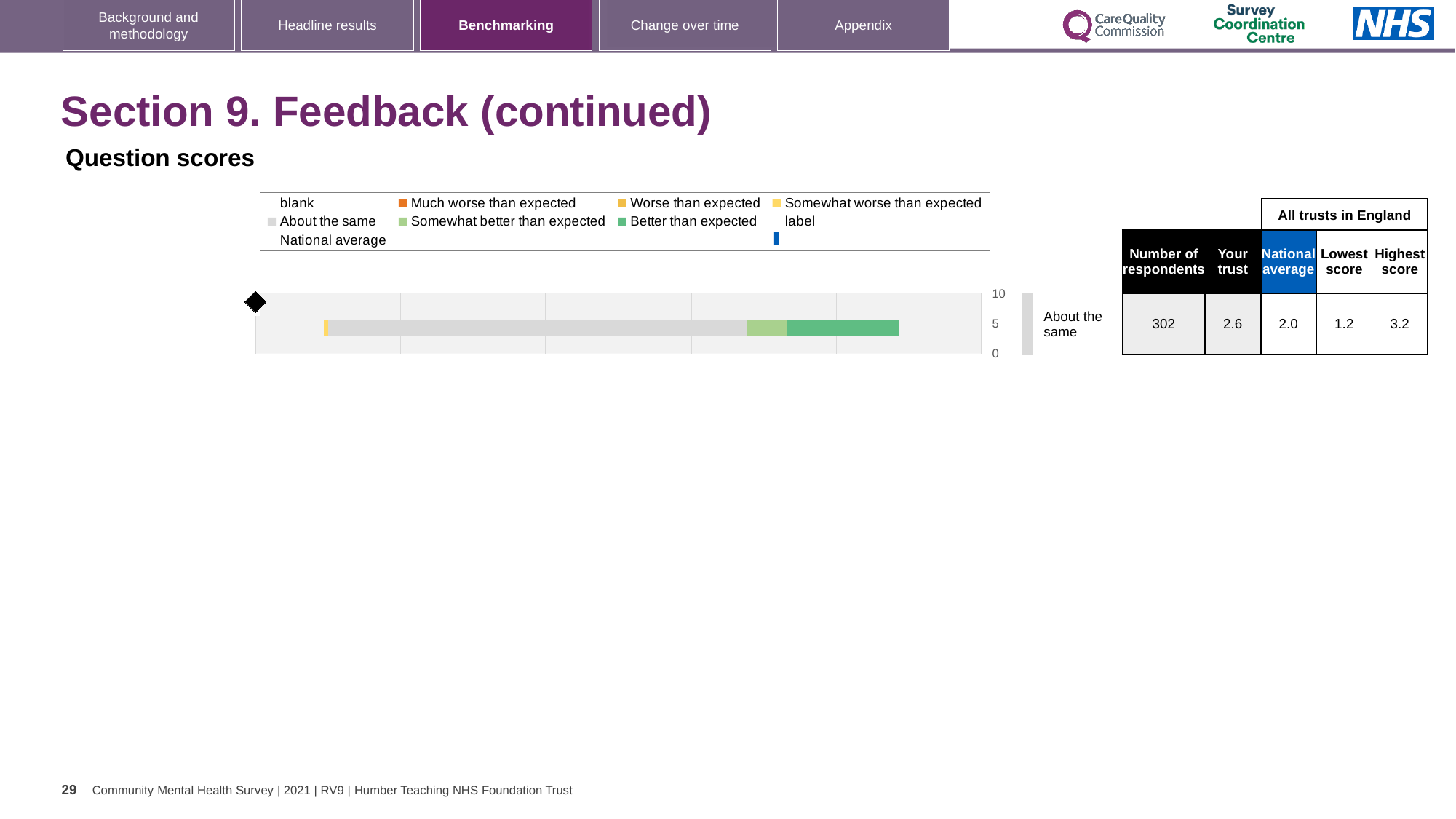
What is the highest score among all trusts in England for the question shown? 3.2 Which is larger for the question shown: the 'Your trust' score or the national average? Your trust What is the 'Your trust' score for the question shown in the chart? 2.6 How many question categories are plotted in the chart? 1 What kind of chart is shown on the slide? bar chart What is the difference between the 'Your trust' score and the national average for the question shown? 0.6 What is the national average score for the question shown in the chart? 2.0 What is the lowest score among all trusts in England for the question shown? 1.2 Which benchmarking category is the trust's result labelled as in the chart? About the same Which legend entry is shown in dark green? Better than expected How many respondents answered the question shown in the chart? 302 What is the difference between the highest and lowest scores among all trusts in England for the question shown? 2.0